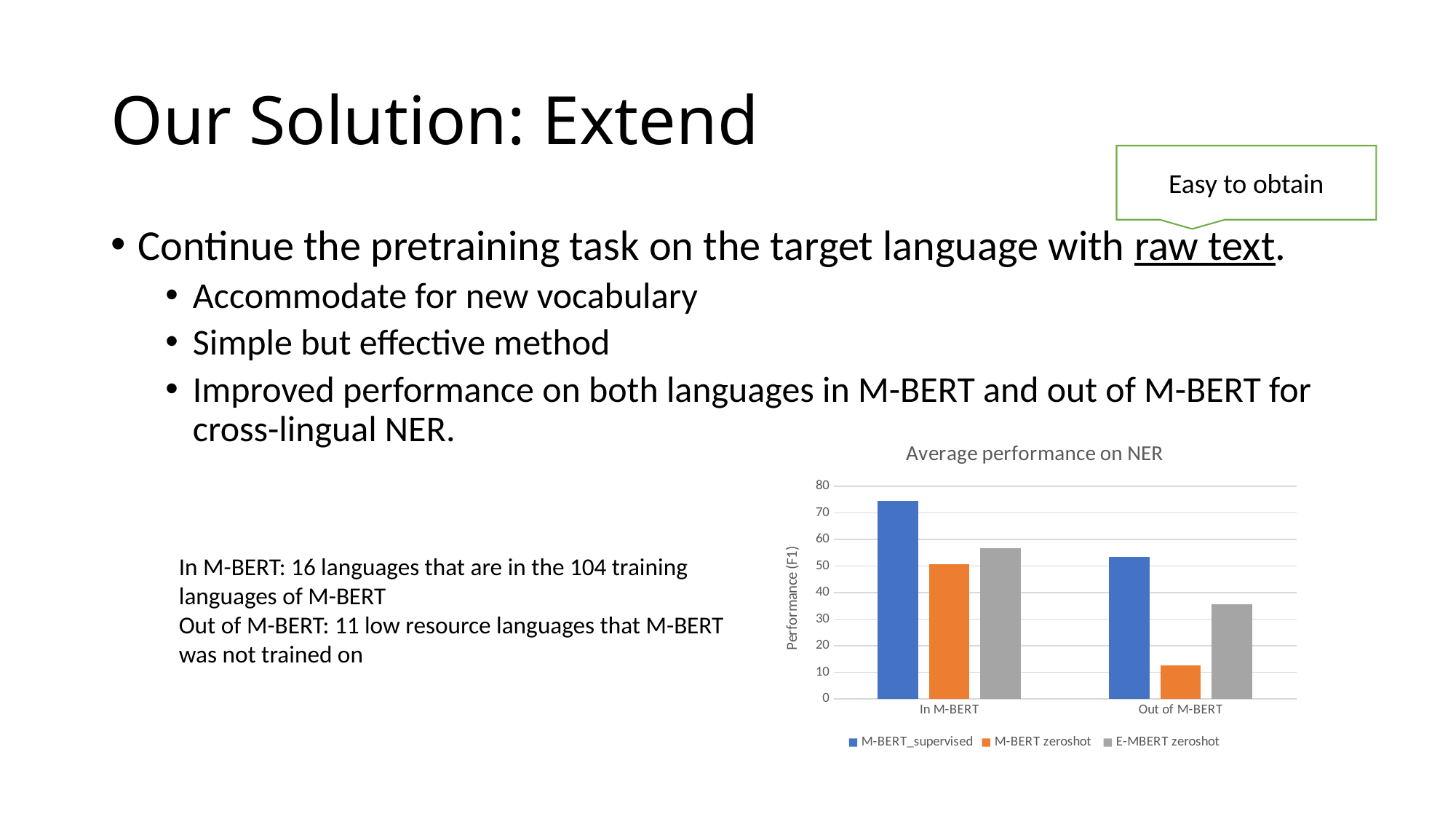
In the In M-BERT category, which is larger: M-BERT zeroshot or E-MBERT zeroshot? E-MBERT zeroshot How many categories are shown on the x axis of the chart? 2 Does the M-BERT_supervised value rise or fall from In M-BERT to Out of M-BERT? fall Which series has the lowest value in the Out of M-BERT category? M-BERT zeroshot What kind of chart is shown on the slide? bar chart What is the title of the chart? Average performance on NER Is the value for M-BERT_supervised in the In M-BERT category greater or less than 70? greater Which series has the highest value in the In M-BERT category? M-BERT_supervised In the Out of M-BERT category, which is larger: M-BERT zeroshot or E-MBERT zeroshot? E-MBERT zeroshot What is the label of the vertical axis? Performance (F1) How many series does the chart legend list? 3 Is the value for M-BERT zeroshot in the Out of M-BERT category greater or less than 20? less